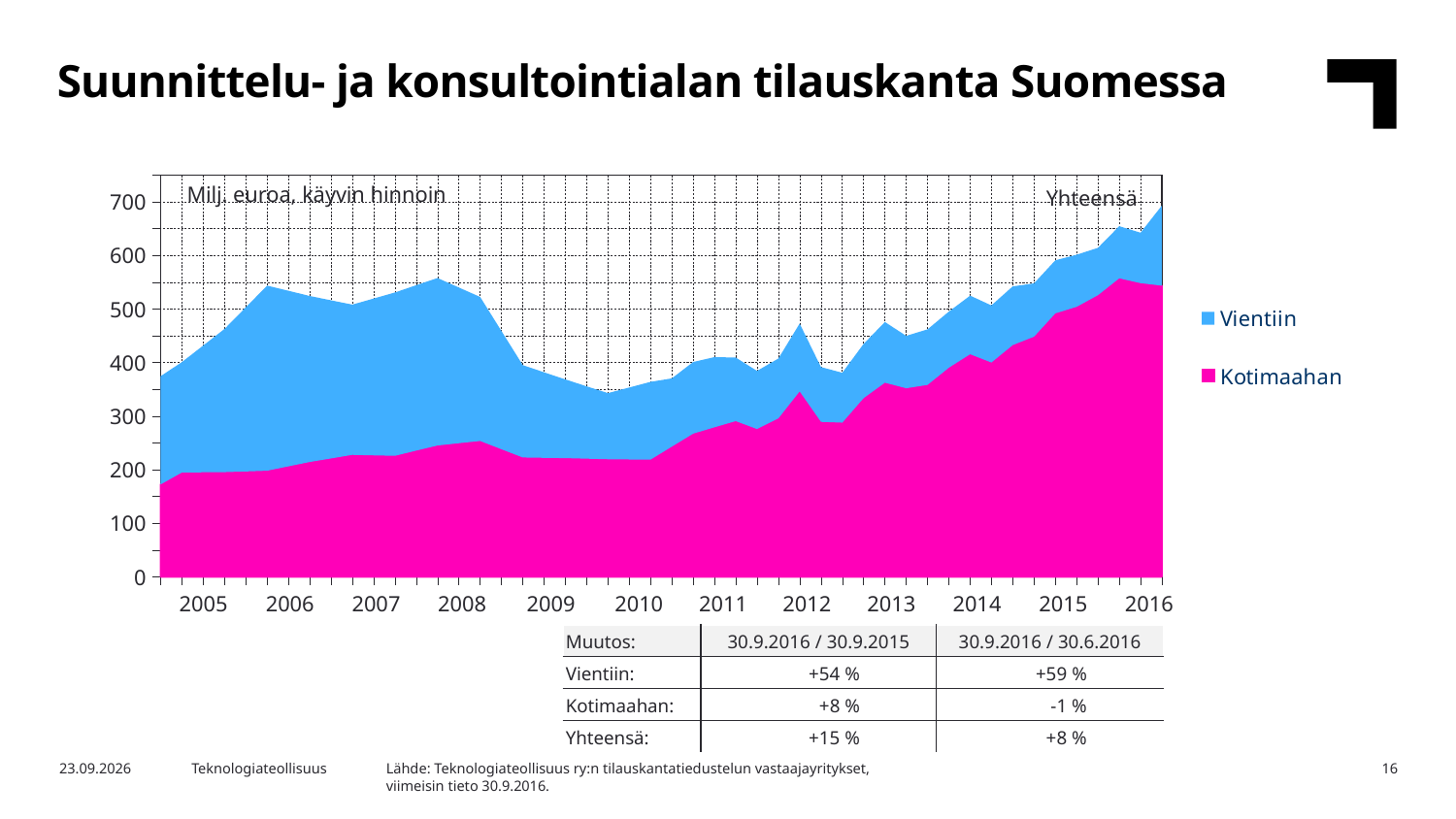
How many years are labelled on the x axis of the chart? 12 How many series does the chart legend list? 2 Does the total (Yhteensä) value rise or fall from 2008 to 2010? fall What are the two series named in the chart legend? Vientiin and Kotimaahan Is the total (Yhteensä) value in 2010 greater or less than 400? less Does the Kotimaahan series rise or fall from 2012 to 2016? rise What kind of chart is shown on the slide? area chart According to the table below the chart, what is the change (Muutos) for Vientiin for 30.9.2016 / 30.9.2015? +54 % Is the total (Yhteensä) value in 2006 greater or less than 500? greater What unit label is printed inside the chart area at the top left? Milj. euroa, käyvin hinnoin Is the Kotimaahan value at the end of 2016 greater or less than 500? greater